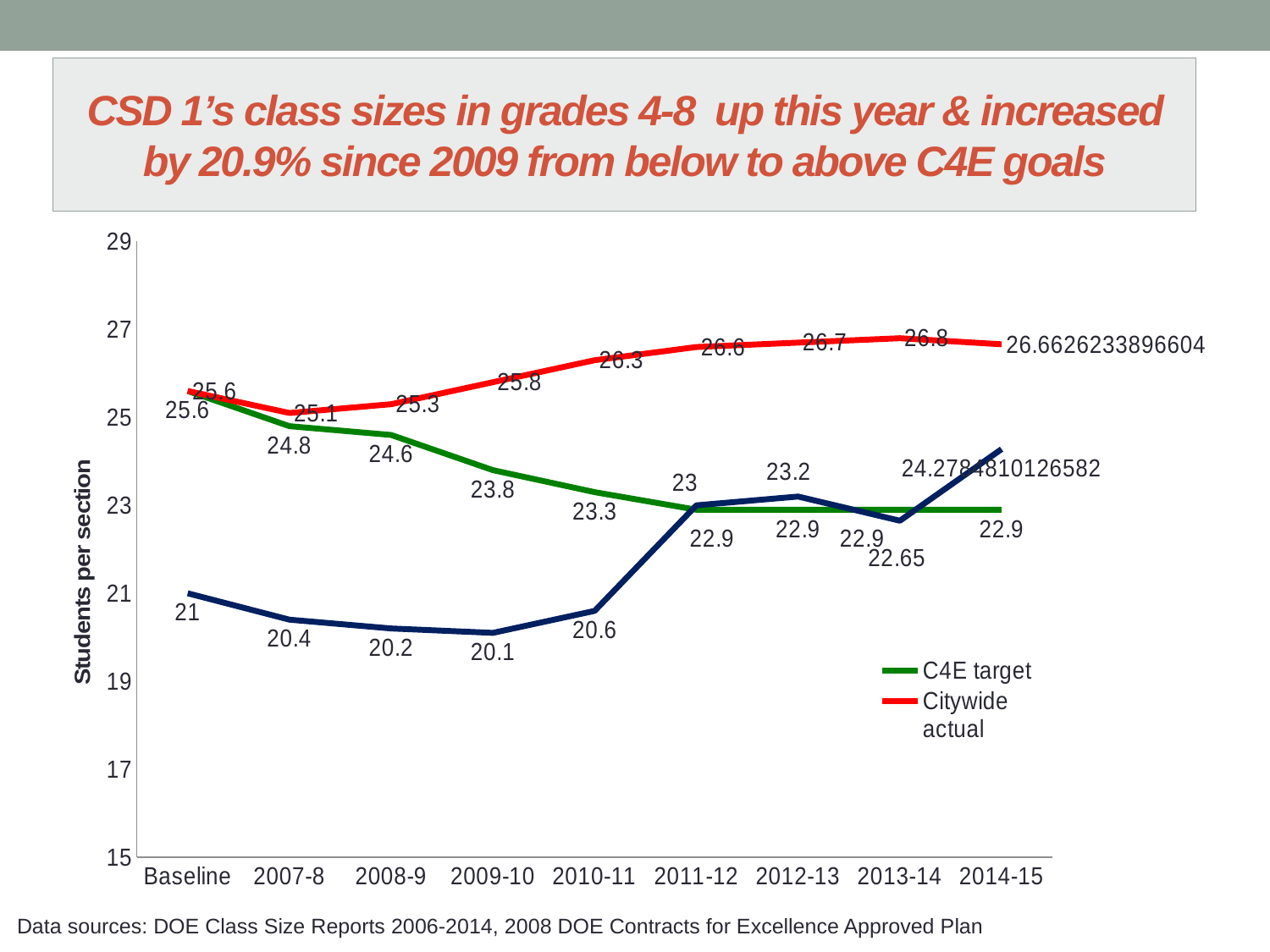
What is the title of the y axis? Students per section In which year is the Citywide actual value lowest? 2007-8 What is the difference between the C4E target at Baseline and in 2014-15? 2.7 How many series does the legend list? 2 In 2011-12, which is larger: the Citywide actual or the C4E target? Citywide actual Does the Citywide actual line rise or fall from 2007-8 to 2013-14? rise What is the Citywide actual value for 2013-14? 26.8 What is the Citywide actual value for 2007-8? 25.1 How many categories are shown on the x axis? 9 What kind of chart is shown on the slide? line chart What is the C4E target value for 2009-10? 23.8 In which year is the Citywide actual value highest? 2013-14